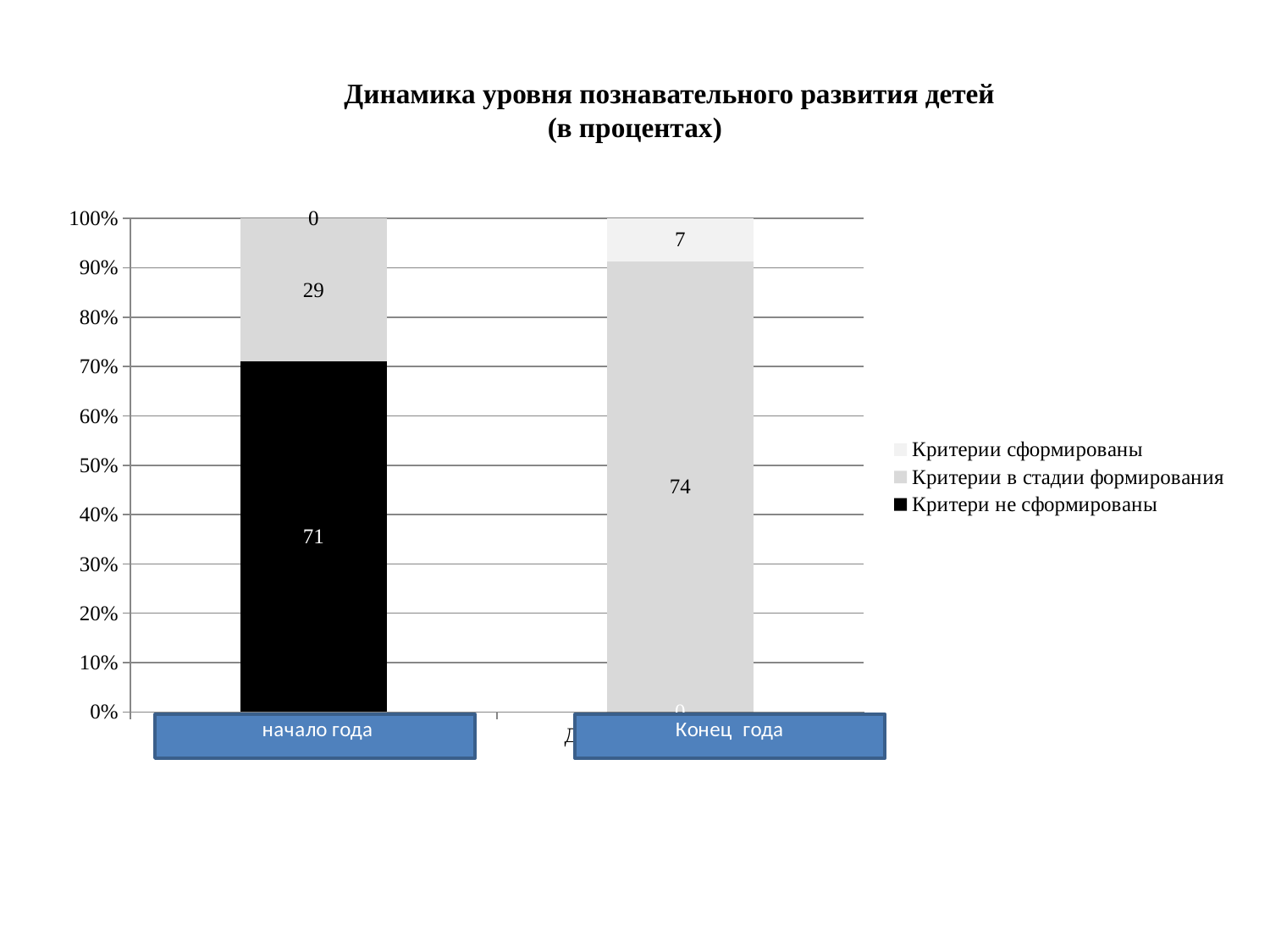
What is the value for "Критерии в стадии формирования" at "начало года"? 29 What is the value for "Критери не сформированы" at "начало года"? 71 What is the total of the stacked bar for "начало года"? 100 Which is larger: "Критерии в стадии формирования" at "начало года" or at "Конец года"? Конец года How many series does the legend list? 3 What is the value for "Критерии в стадии формирования" at "Конец года"? 74 What type of chart is shown on the slide? stacked bar chart What is the title of the chart? Динамика уровня познавательного развития детей (в процентах) What is the value for "Критерии сформированы" at "Конец года"? 7 What is the value for "Критерии сформированы" at "начало года"? 0 What is the difference between "Критерии в стадии формирования" at "Конец года" and at "начало года"? 45 How many categories are shown on the x axis? 2